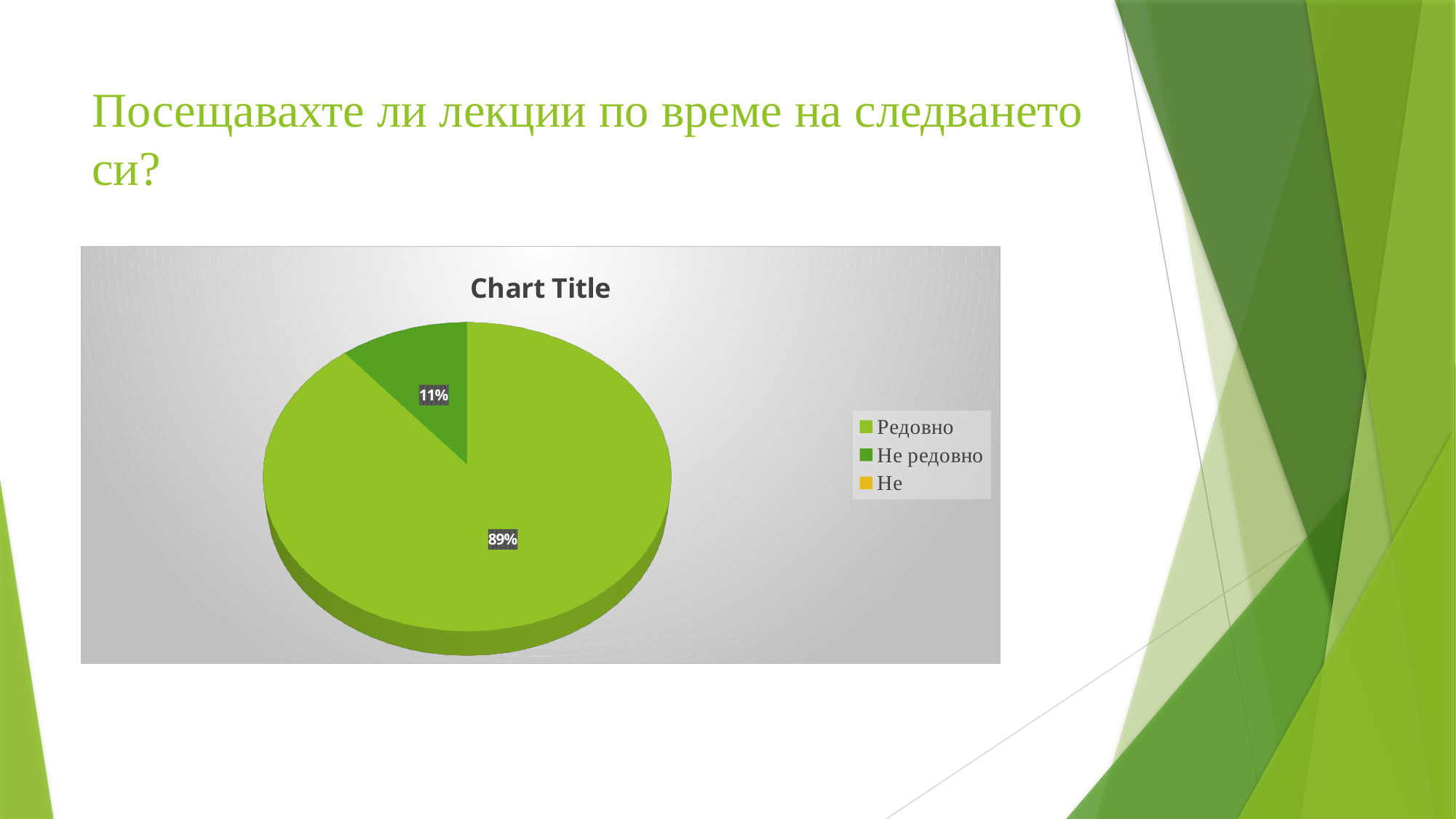
Which category has the largest slice of the pie? Редовно How many slices have a percentage label printed on the pie? 2 How many entries does the legend list? 3 What percentage is shown for the Редовно slice? 89% Which of the two labelled slices is smaller, Редовно or Не редовно? Не редовно What is the difference in percentage points between the Редовно and Не редовно slices? 78 Which is larger, the Редовно slice or the Не редовно slice? Редовно What percentage is shown for the Не редовно slice? 11% What is the title shown above the chart? Chart Title Which legend entry is shown with a yellow/orange colour marker? Не What share of the pie does the Редовно slice represent? 89% What type of chart is shown on the slide? pie chart